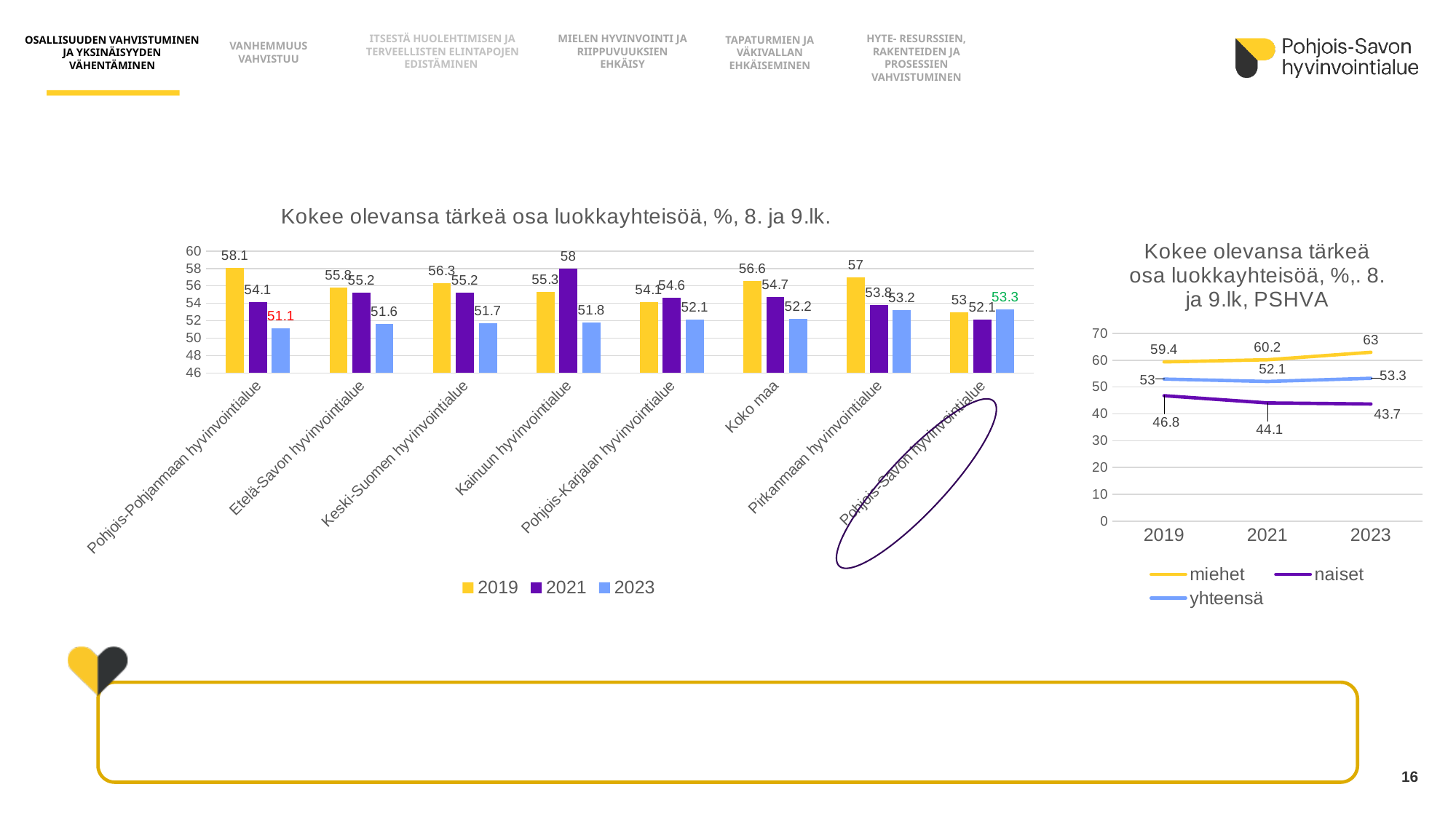
In the bar chart on the left, which region has the highest 2021 value? Kainuun hyvinvointialue In the line chart on the right, what is the difference between miehet and naiset in 2019? 12.6 In the bar chart on the left, what is the difference between the 2019 and 2023 values for Koko maa? 4.4 What kind of chart is the chart on the right titled 'Kokee olevansa tärkeä osa luokkayhteisöä, %,. 8. ja 9.lk, PSHVA'? line chart In the bar chart on the left, which is larger for Pohjois-Savon hyvinvointialue: the 2019 value or the 2023 value? 2023 In the bar chart on the left, what is the 2023 value for Pohjois-Savon hyvinvointialue? 53.3 In the bar chart on the left, what is the 2019 value for Pohjois-Pohjanmaan hyvinvointialue? 58.1 In the line chart on the right, do the values for miehet rise or fall from 2019 to 2023? rise In the line chart on the right, what is the value for naiset in 2023? 43.7 In the bar chart on the left, which category has the lowest 2023 value? Pohjois-Pohjanmaan hyvinvointialue How many categories are shown on the x axis of the bar chart on the left? 8 How many series does the legend of the bar chart on the left list? 3